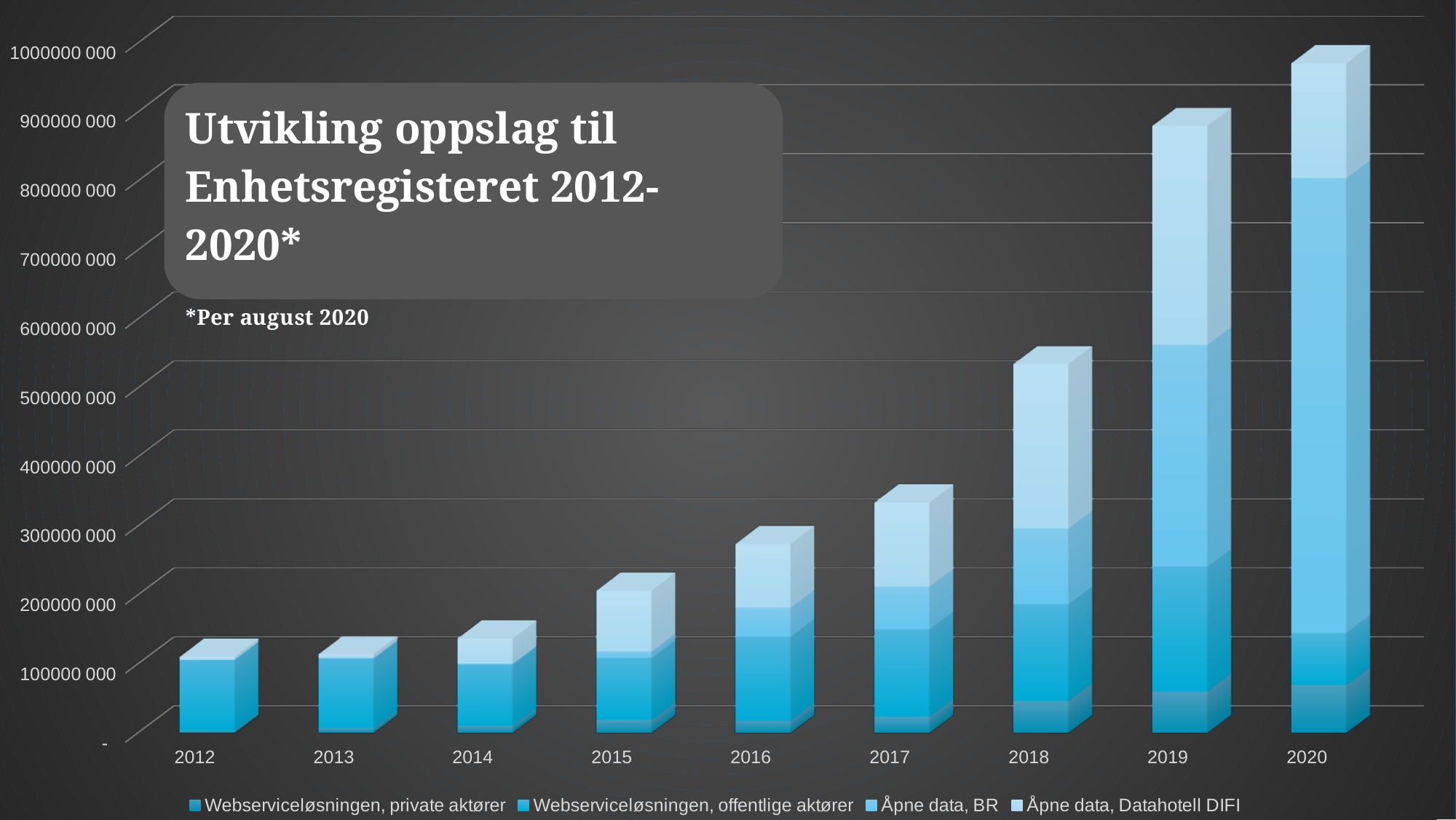
Which year has the tallest stacked bar in the chart? 2020 Do the total values rise or fall from 2012 to 2020 along the x axis? Rise What does the footnote below the chart title say? *Per august 2020 What kind of chart is shown on the slide? Stacked bar chart Is the total value for 2020 greater or less than 900000 000? greater Is the total value for 2016 greater or less than 300000 000? less How many series does the chart's legend list? 4 How many years (categories) are shown on the x axis of the chart? 9 Is the total value for 2013 greater or less than 200000 000? less Which year has the larger total, 2017 or 2018? 2018 What is the title of the chart? Utvikling oppslag til Enhetsregisteret 2012-2020*